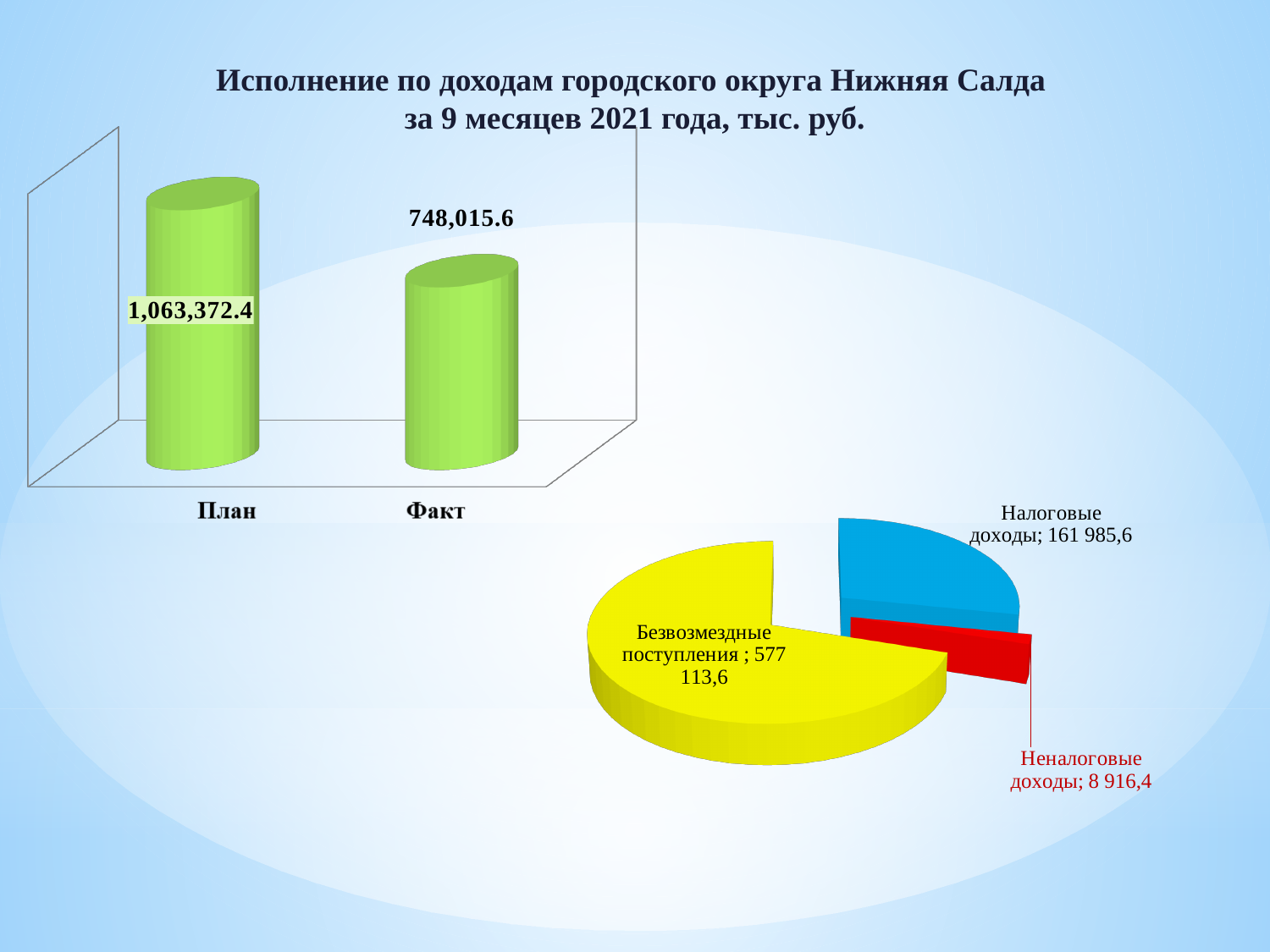
On the bar chart, what is the value for План? 1,063,372.4 On the pie chart, how many slices are there? 3 What type of chart is the chart on the left with План and Факт? Bar chart On the pie chart, what is the value for Неналоговые доходы? 8 916,4 On the pie chart, what is the value for Налоговые доходы? 161 985,6 On the pie chart, what is the value for Безвозмездные поступления? 577 113,6 On the bar chart, what is the difference between the План and Факт values? 315,356.8 On the bar chart, which category has the higher value, План or Факт? План On the pie chart, which category has the smallest slice? Неналоговые доходы On the pie chart, which category has the largest slice? Безвозмездные поступления On the bar chart, how many categories are shown? 2 On the bar chart, what is the value for Факт? 748,015.6